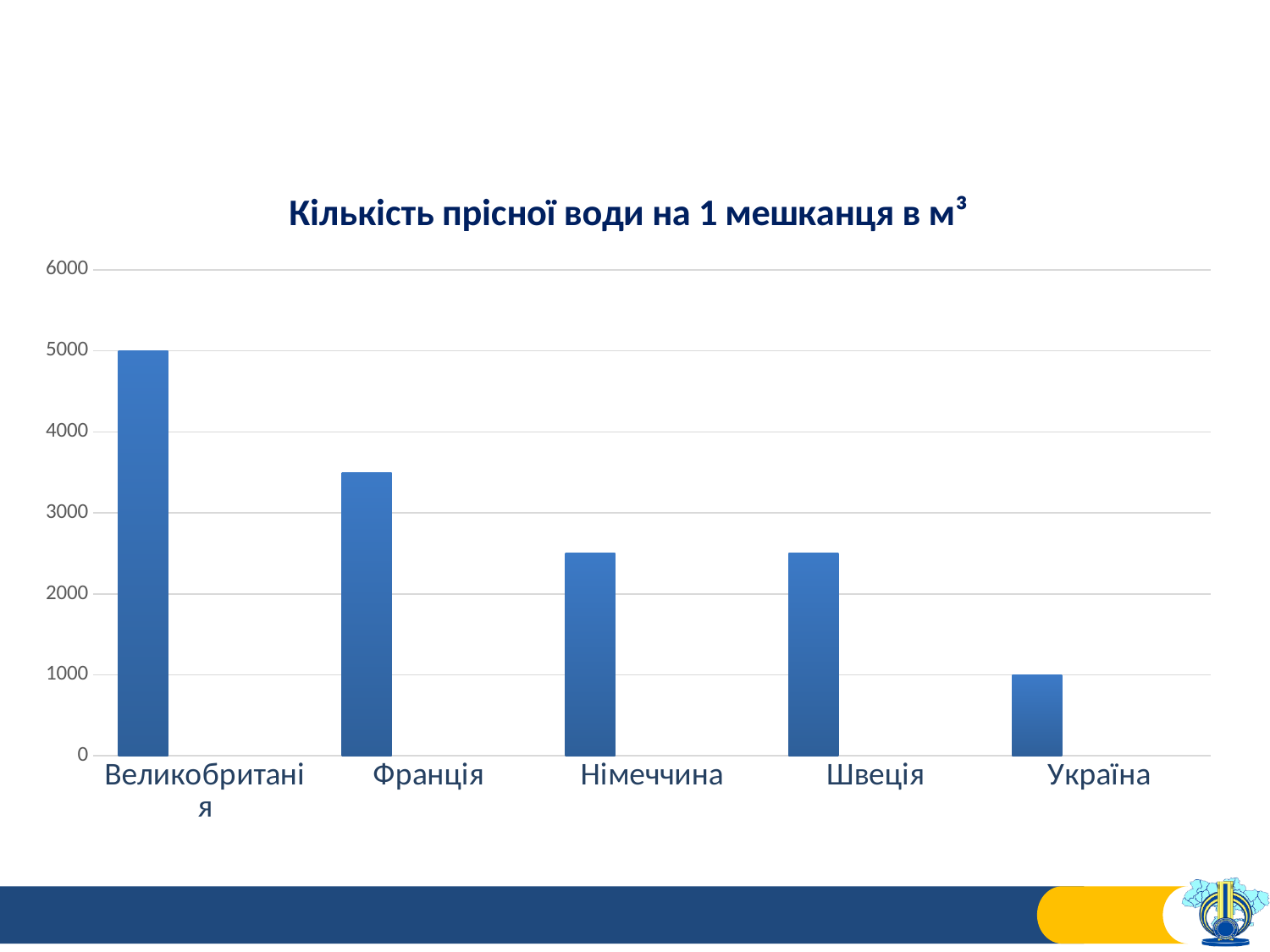
Is the value for Франція greater or less than 3000? greater Which country has the lowest value? Україна Do the values generally rise or fall from left to right across the countries? fall Which country has the highest value? Великобританія What is the value for Великобританія? 5000 What is the title of the chart? Кількість прісної води на 1 мешканця в м³ What is the difference between the values for Великобританія and Україна? 4000 What is the value for Україна? 1000 What kind of chart is shown on the slide? bar chart How many countries are shown on the chart? 5 Which is larger, the value for Франція or the value for Швеція? Франція Is the value for Німеччина greater or less than 3000? less